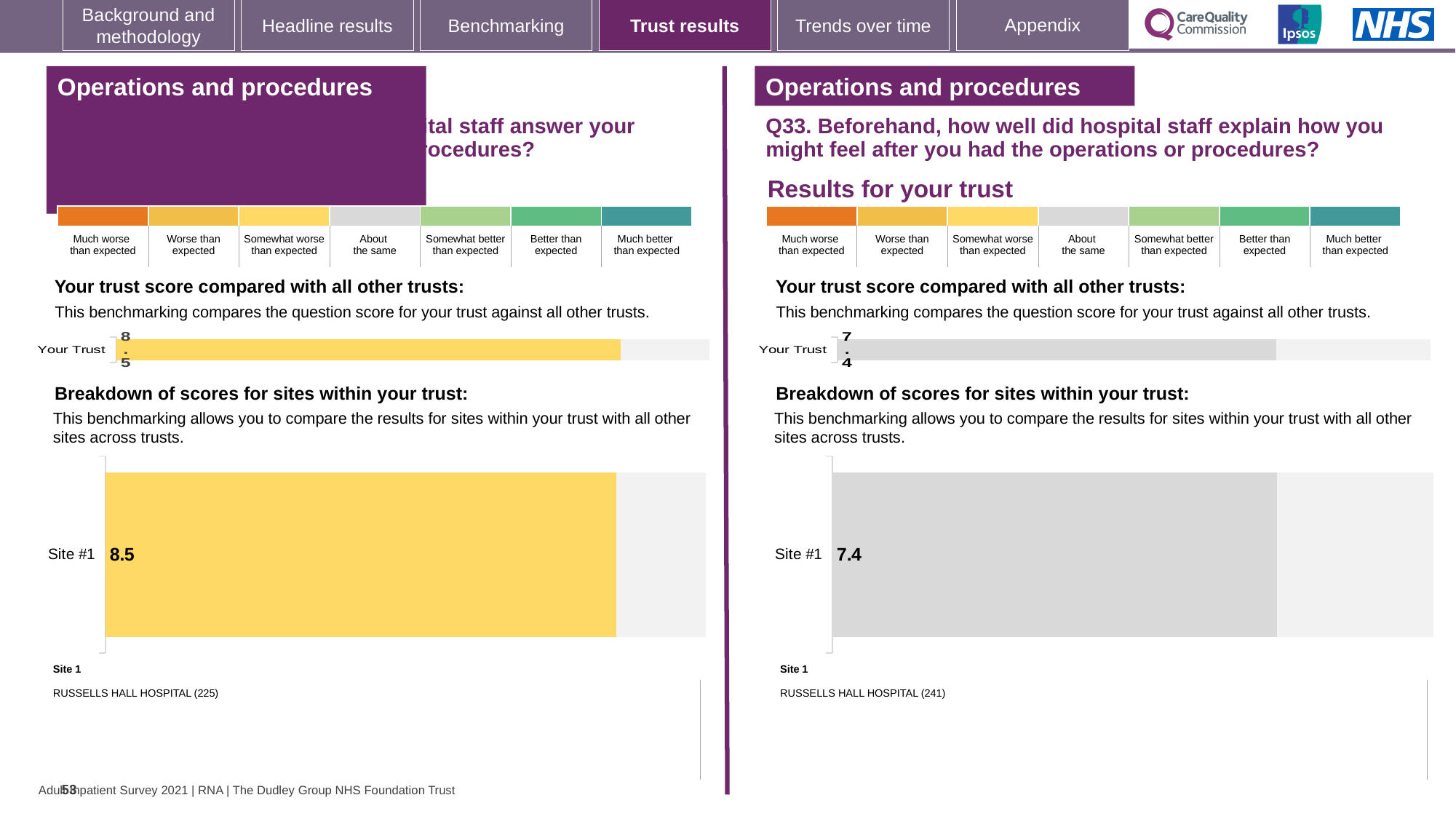
On the left-hand site breakdown chart, what is the score for Site #1? 8.5 Which is larger: the 'Your Trust' score on the left-hand chart or the 'Your Trust' score on the right-hand chart for Q33? The left-hand chart (8.5) On the left-hand chart, what is the trust score shown for 'Your Trust'? 8.5 What kind of chart is used to show the Site #1 score on the right-hand side for Q33? Bar chart How many sites are shown in the site breakdown chart on the right-hand side for Q33? 1 How many sites are shown in the site breakdown chart on the left-hand side? 1 What is the difference between the Site #1 score on the left-hand chart and the Site #1 score on the right-hand chart for Q33? 1.1 Which hospital is listed as Site 1 on the right-hand side for Q33? RUSSELLS HALL HOSPITAL (241) On the right-hand chart for Q33, what is the trust score shown for 'Your Trust'? 7.4 What colour is the Site #1 bar on the left-hand site breakdown chart? Yellow On the right-hand site breakdown chart for Q33, what is the score for Site #1? 7.4 Is the Site #1 score on the right-hand chart for Q33 greater or less than 8? less